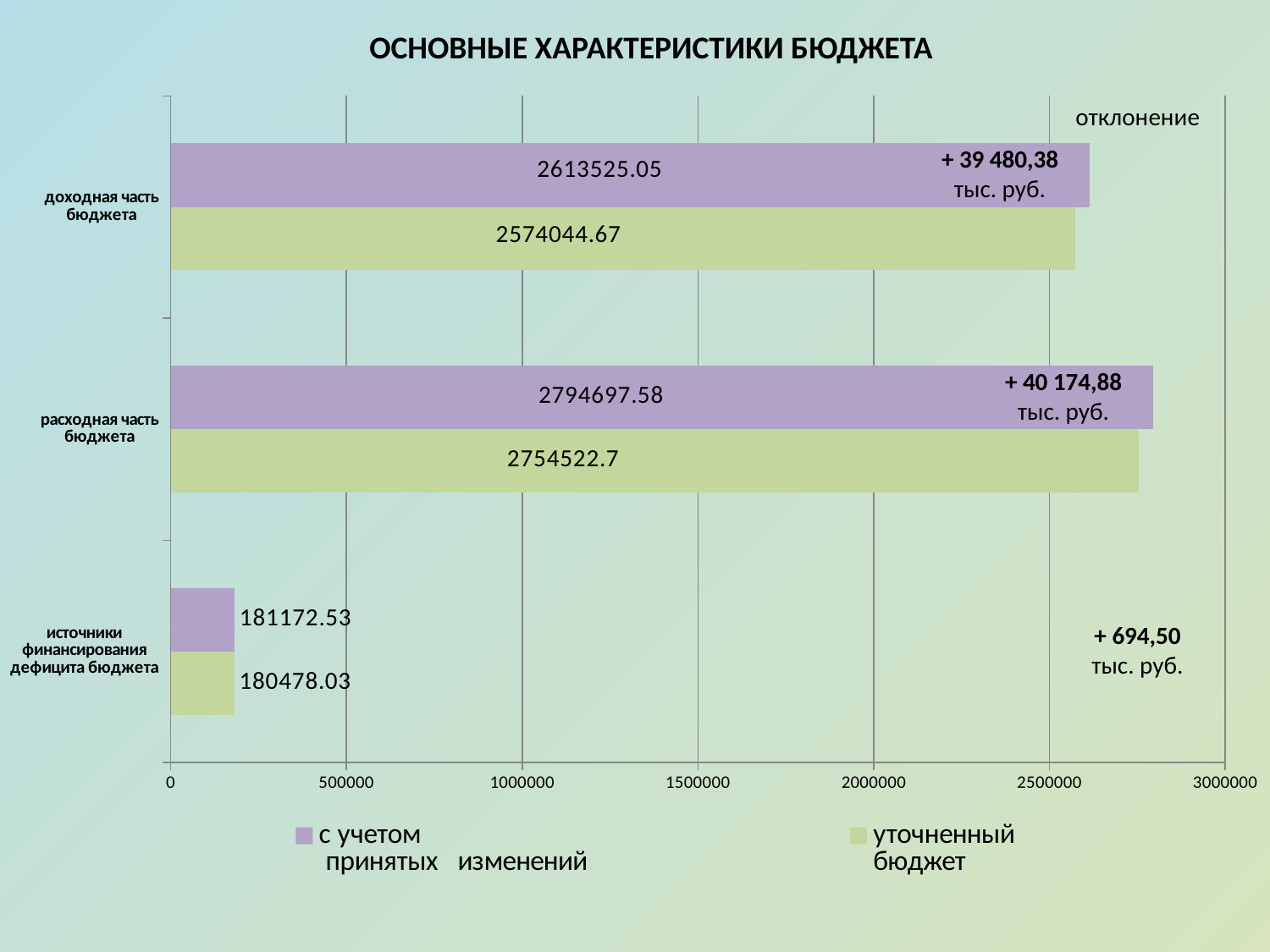
How many categories are shown on the chart? 3 Which category has the highest value in the "с учетом принятых изменений" series? расходная часть бюджета What is the value for "доходная часть бюджета" in the "с учетом принятых изменений" series? 2613525.05 Which category has the lowest value in the "уточненный бюджет" series? источники финансирования дефицита бюджета What kind of chart is shown on the slide? bar chart Which is larger for "доходная часть бюджета": the "с учетом принятых изменений" value or the "уточненный бюджет" value? с учетом принятых изменений What is the value for "расходная часть бюджета" in the "уточненный бюджет" series? 2754522.7 How many series does the legend list? 2 Is the "уточненный бюджет" value for "доходная часть бюджета" greater or less than 2500000? greater What is the difference between the "с учетом принятых изменений" and "уточненный бюджет" values for "расходная часть бюджета"? 40174.88 What is the title of the chart? ОСНОВНЫЕ ХАРАКТЕРИСТИКИ БЮДЖЕТА What is the value for "источники финансирования дефицита бюджета" in the "с учетом принятых изменений" series? 181172.53